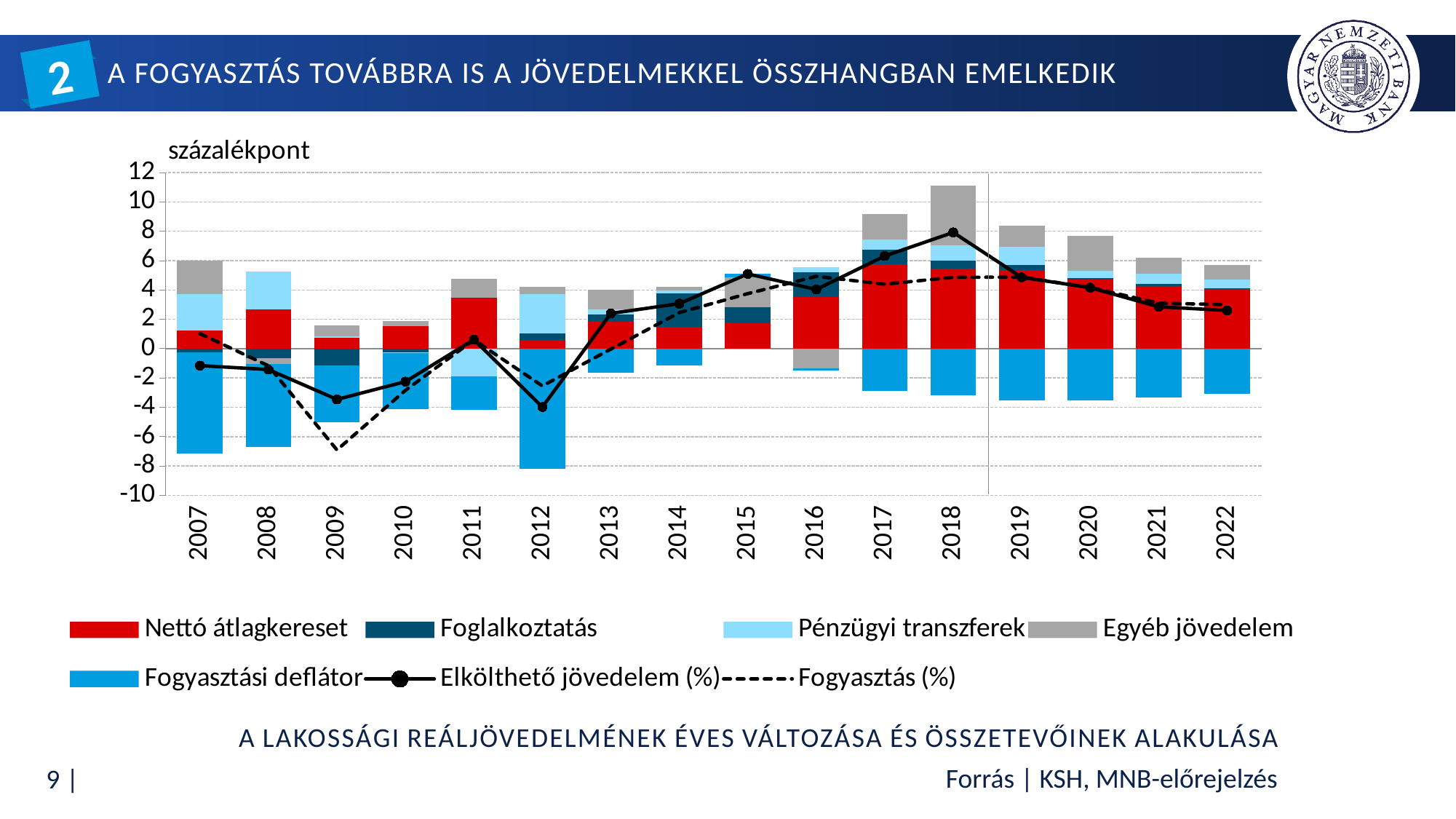
What unit is written above the y axis of the chart? százalékpont In which year does the Elkölthető jövedelem (%) line reach its highest value? 2018 Does the Elkölthető jövedelem (%) line rise or fall from 2018 to 2022? fall Is the Fogyasztási deflátor bar segment in 2012 greater or less than -6? less What is the title of the chart shown below the legend? A lakossági reáljövedelmének éves változása és összetevőinek alakulása What kind of chart is shown on the slide? A stacked bar chart combined with line series Which year has the larger value on the Elkölthető jövedelem (%) line, 2017 or 2018? 2018 In which year does the Fogyasztás (%) line reach its lowest value? 2009 How many years are shown on the x axis of the chart? 16 How many series does the legend of the chart list? 7 Is the value of the Elkölthető jövedelem (%) line in 2018 greater or less than 6? greater Is the value of the Fogyasztás (%) line in 2009 greater or less than -4? less